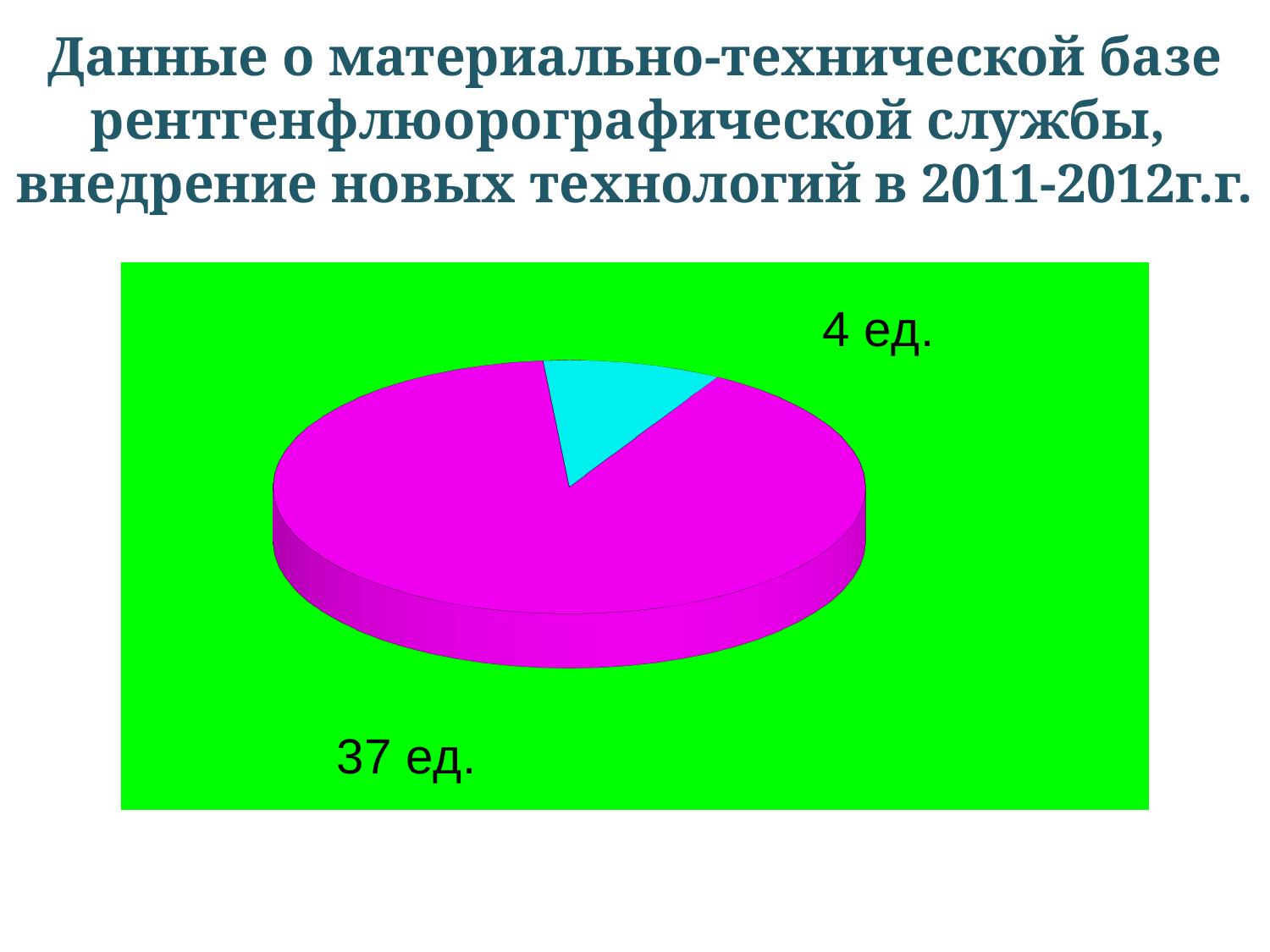
What is the difference between the values of the magenta slice and the cyan slice? 33 ед. Which years are mentioned in the slide title above the chart? 2011-2012 How many slices does the pie chart have? 2 What value is labelled on the magenta slice of the pie chart? 37 ед. What kind of chart is shown on the slide? pie chart Which is larger, the magenta slice or the cyan slice? the magenta slice What value is labelled on the cyan slice of the pie chart? 4 ед. What is the total of the two values shown on the pie chart? 41 ед. Which slice of the pie chart has the smallest value? the cyan slice (4 ед.) Which slice of the pie chart has the largest value? the magenta slice (37 ед.) What is the background colour of the chart area? green